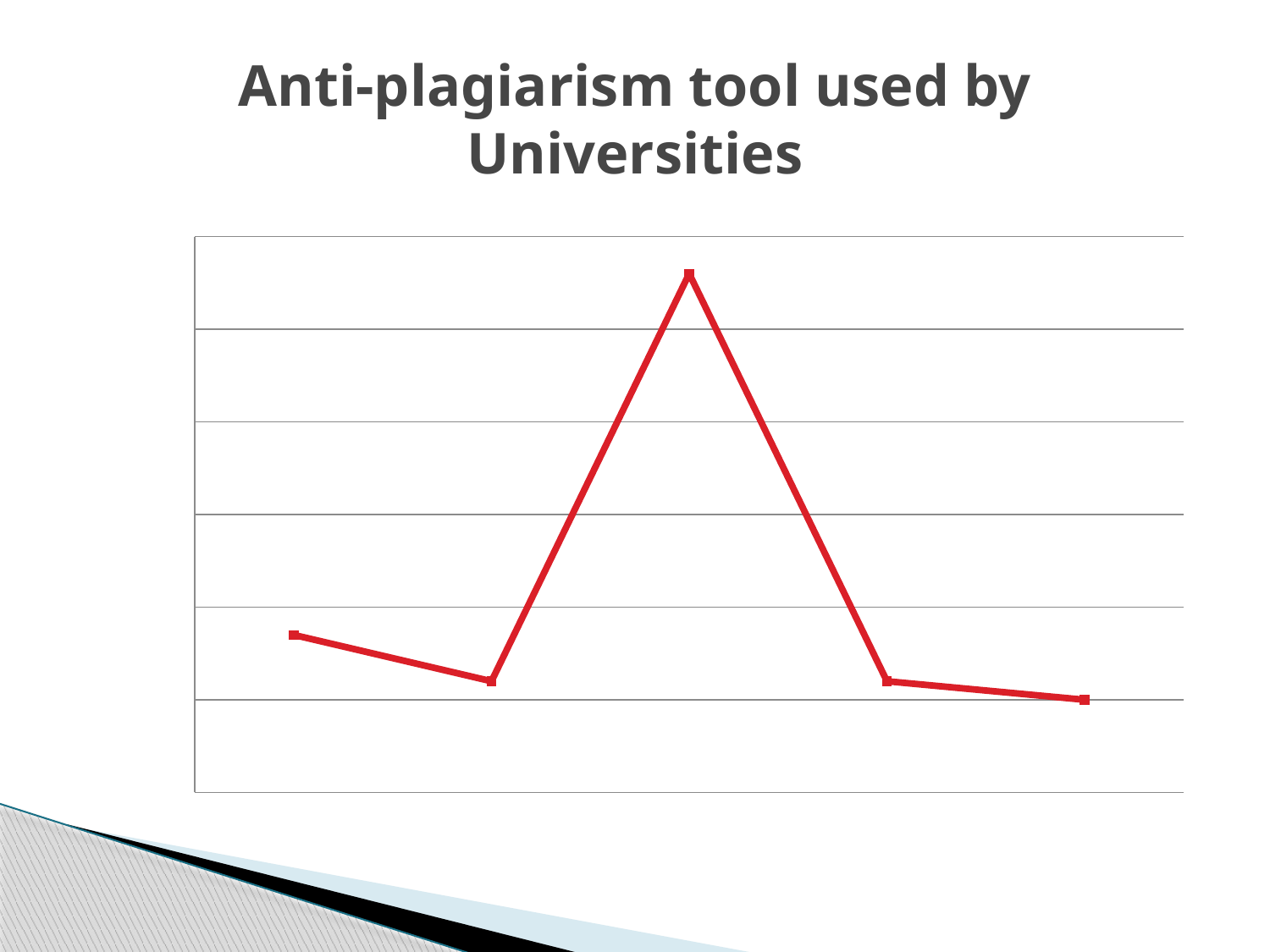
What colour is the plotted line? red What kind of chart is shown on the slide? line chart Does the line rise or fall from the second point to the third point? rise Which data point on the line is the lowest? the fifth (last) point Which is larger, the first data point or the second data point? the first data point Which is larger, the third data point or the fourth data point? the third data point Which data point on the line is the highest? the third (middle) point Does the line rise or fall from the third point to the fifth point? fall How many data points are plotted on the line? 5 What is the title shown above the chart? Anti-plagiarism tool used by Universities Does the line rise or fall from the first point to the second point? fall